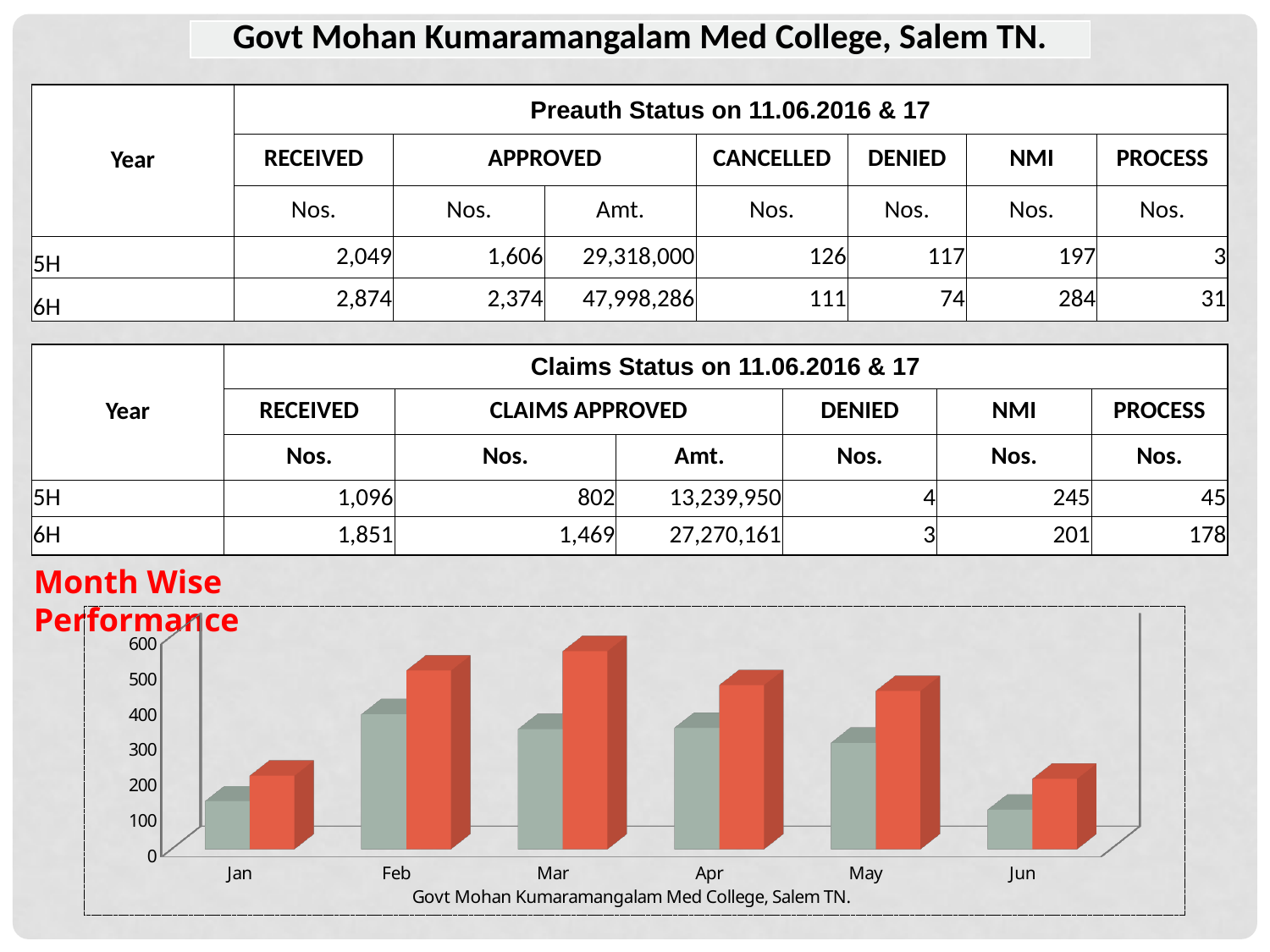
What text appears below the x axis of the Month Wise Performance chart? Govt Mohan Kumaramangalam Med College, Salem TN. In the Month Wise Performance chart, do the red bars rise or fall from Mar to Jun? fall In the Month Wise Performance chart, which is taller for Apr: the grey bar or the red bar? the red bar In the Month Wise Performance chart, is the grey bar for Jan greater or less than 200? less What kind of chart is shown under the heading "Month Wise Performance"? bar chart In the Month Wise Performance chart, which month has the tallest red bar? Mar How many bars are plotted for each month in the Month Wise Performance chart? 2 In the Month Wise Performance chart, is the red bar for Jun greater or less than 300? less How many months are shown on the x axis of the Month Wise Performance chart? 6 In the Month Wise Performance chart, is the grey bar for May greater or less than 400? less In the Month Wise Performance chart, which month has the tallest grey bar? Feb